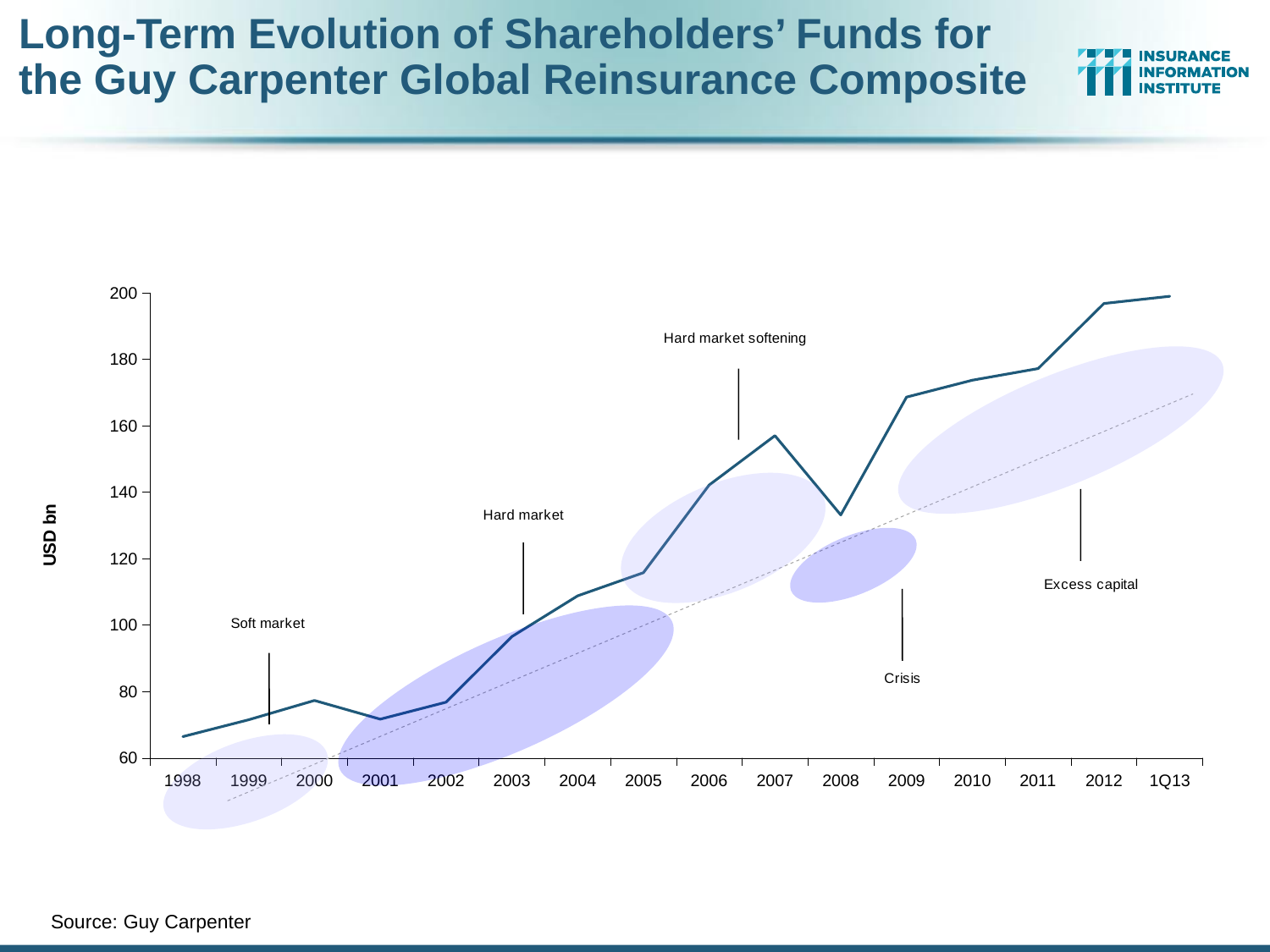
What is the source cited for the chart? Guy Carpenter What kind of chart is shown on the slide? line chart Is the value for 2012 greater or less than 180? greater What is the label on the vertical axis? USD bn Is the value for 2008 greater or less than 140? less Overall, do shareholders' funds rise or fall from 1998 to 1Q13? rise Which year has the lowest value of shareholders' funds? 1998 How many time points are plotted along the x axis? 16 Which is larger, the value for 2007 or the value for 2008? 2007 Is the value for 2007 greater or less than 140? greater